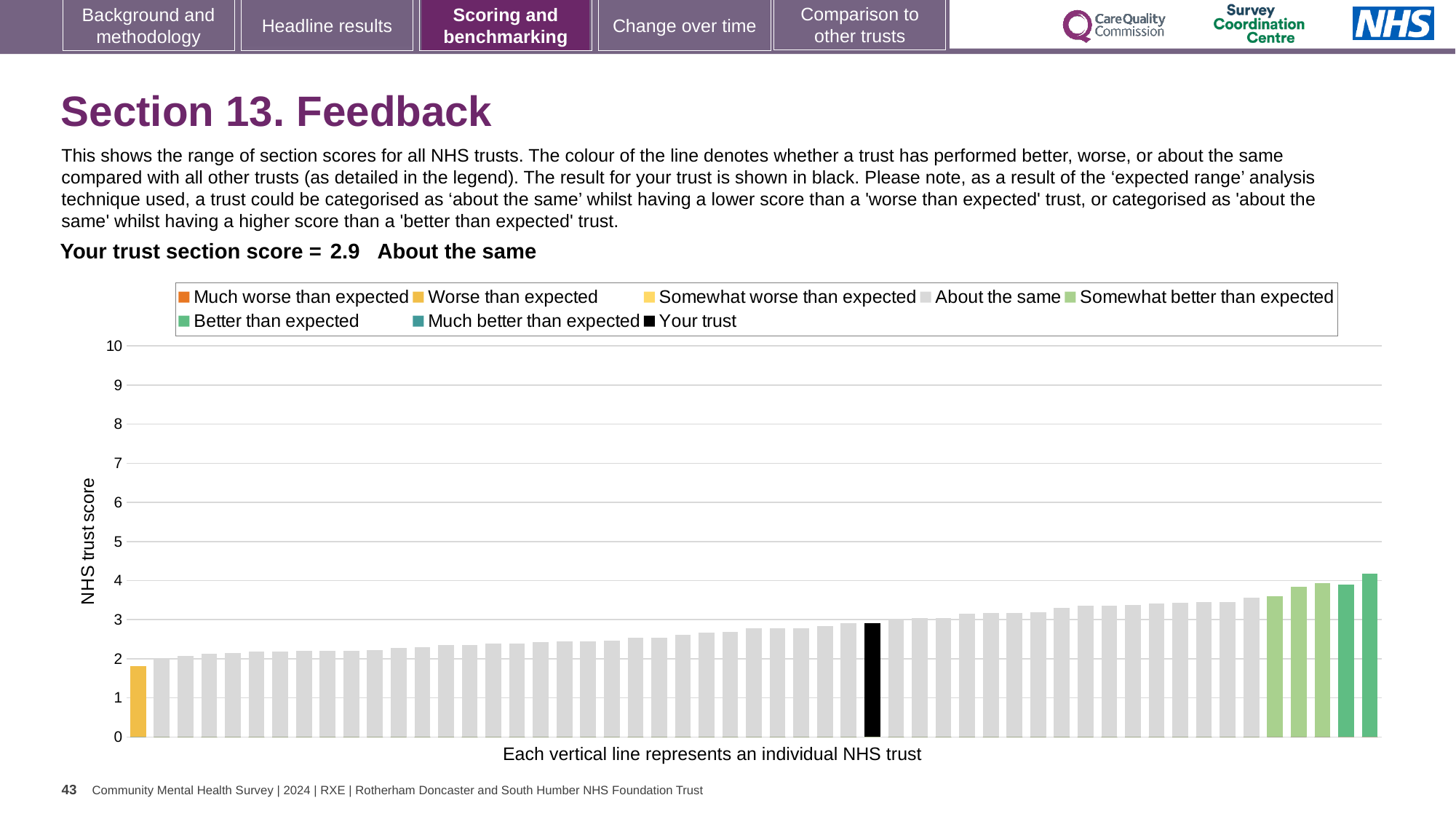
How many entries does the chart legend list? 8 Do the trust scores rise or fall from left to right along the x axis? rise Is the highest-scoring trust's bar greater or less than 3? greater How many trusts are shown in the 'Better than expected' (dark green) colour? 2 Is the lowest-scoring trust's bar greater or less than 3? less What is the section score for your trust shown on the slide? 2.9 What kind of chart is shown on the slide? bar chart Which performance category is your trust placed in for Section 13? About the same What colour is the bar representing your trust? black Is the score for your trust greater or less than 5? less What is the label on the y axis of the chart? NHS trust score Is your trust's score higher or lower than the highest-scoring trust? lower